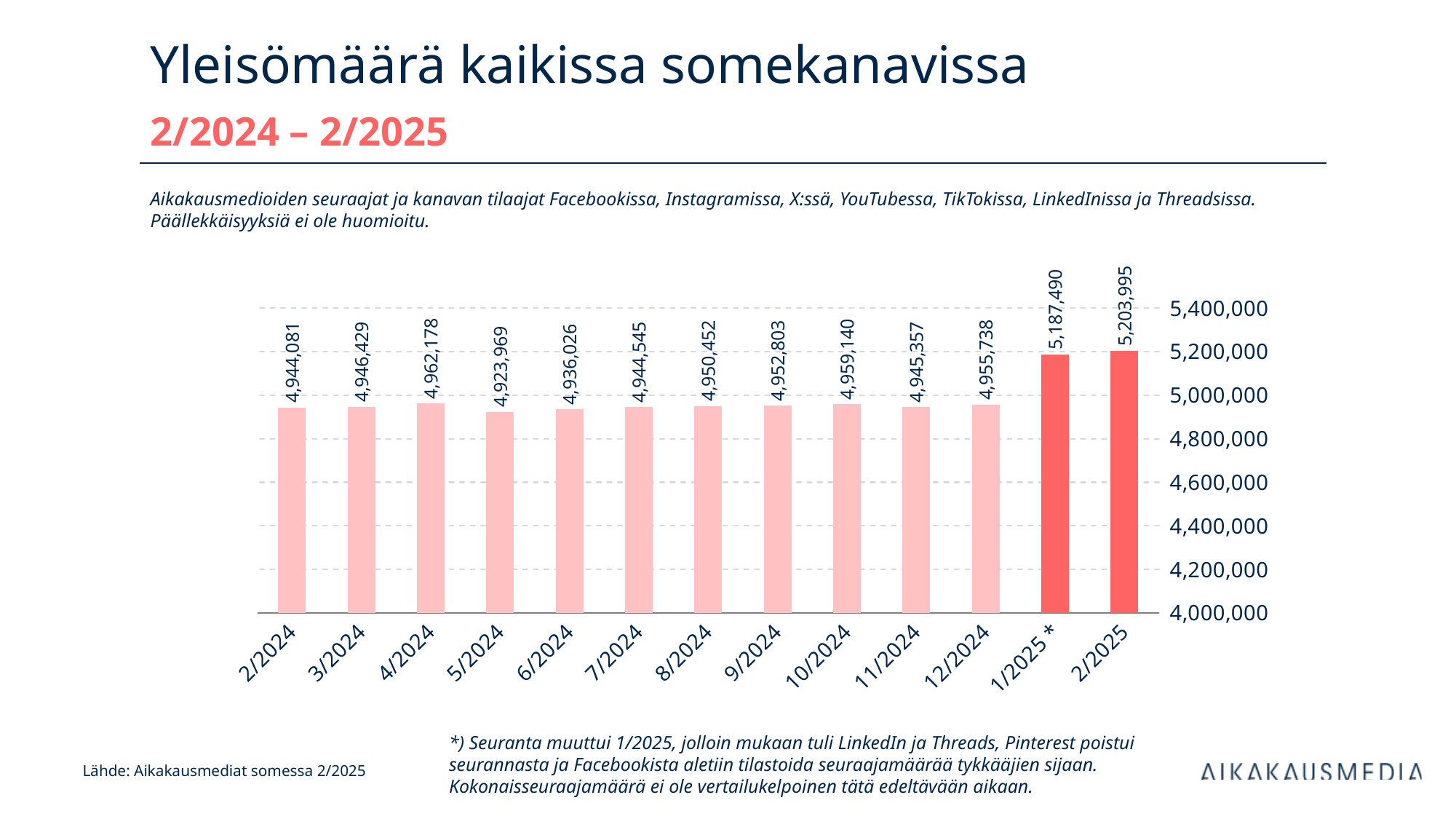
What is the title of the chart? Yleisömäärä kaikissa somekanavissa How many months are shown on the x axis? 13 What is the value for 1/2025 *? 5,187,490 Is the value for 1/2025 * greater or less than 5,000,000? greater Which month has the lowest value? 5/2024 What is the value for 2/2024? 4,944,081 What is the value for 10/2024? 4,959,140 Which month has the highest value? 2/2025 What is the difference between the values for 4/2024 and 5/2024? 38,209 What kind of chart is shown on the slide? bar chart What is the difference between the values for 2/2025 and 1/2025 *? 16,505 Which is larger, the value for 4/2024 or the value for 5/2024? 4/2024